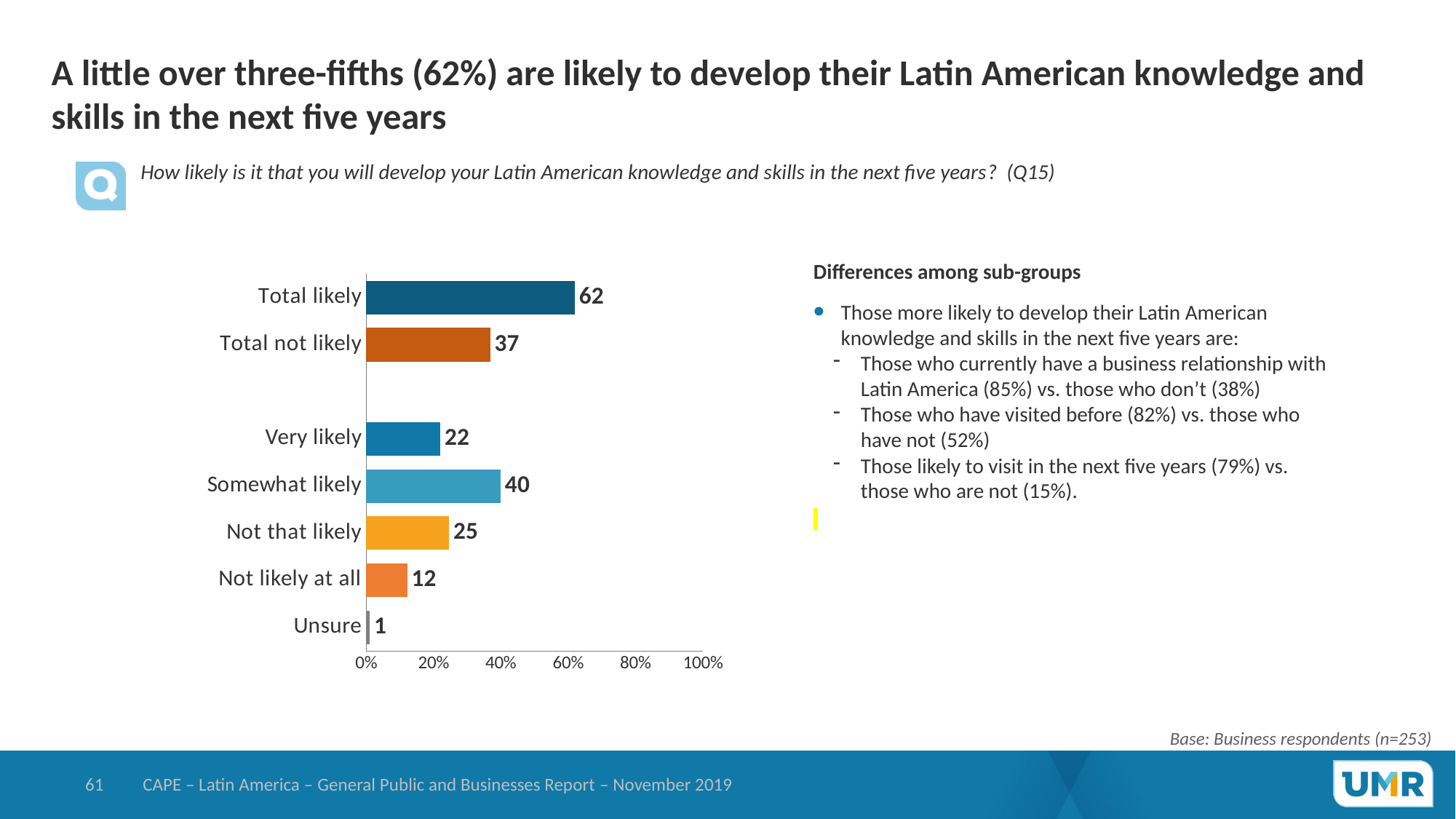
What is the difference between Total likely and Total not likely? 25 What is the value for Total likely? 62 What is the difference between Somewhat likely and Very likely? 18 What is the value for Unsure? 1 Which is larger, Not that likely or Very likely? Not that likely What is the value for Somewhat likely? 40 What is the value for Not likely at all? 12 How many categories are shown in the chart? 7 What kind of chart is shown on the slide? bar chart Is the value for Total likely greater or less than 60%? greater Which category has the highest value? Total likely Which category has the lowest value? Unsure